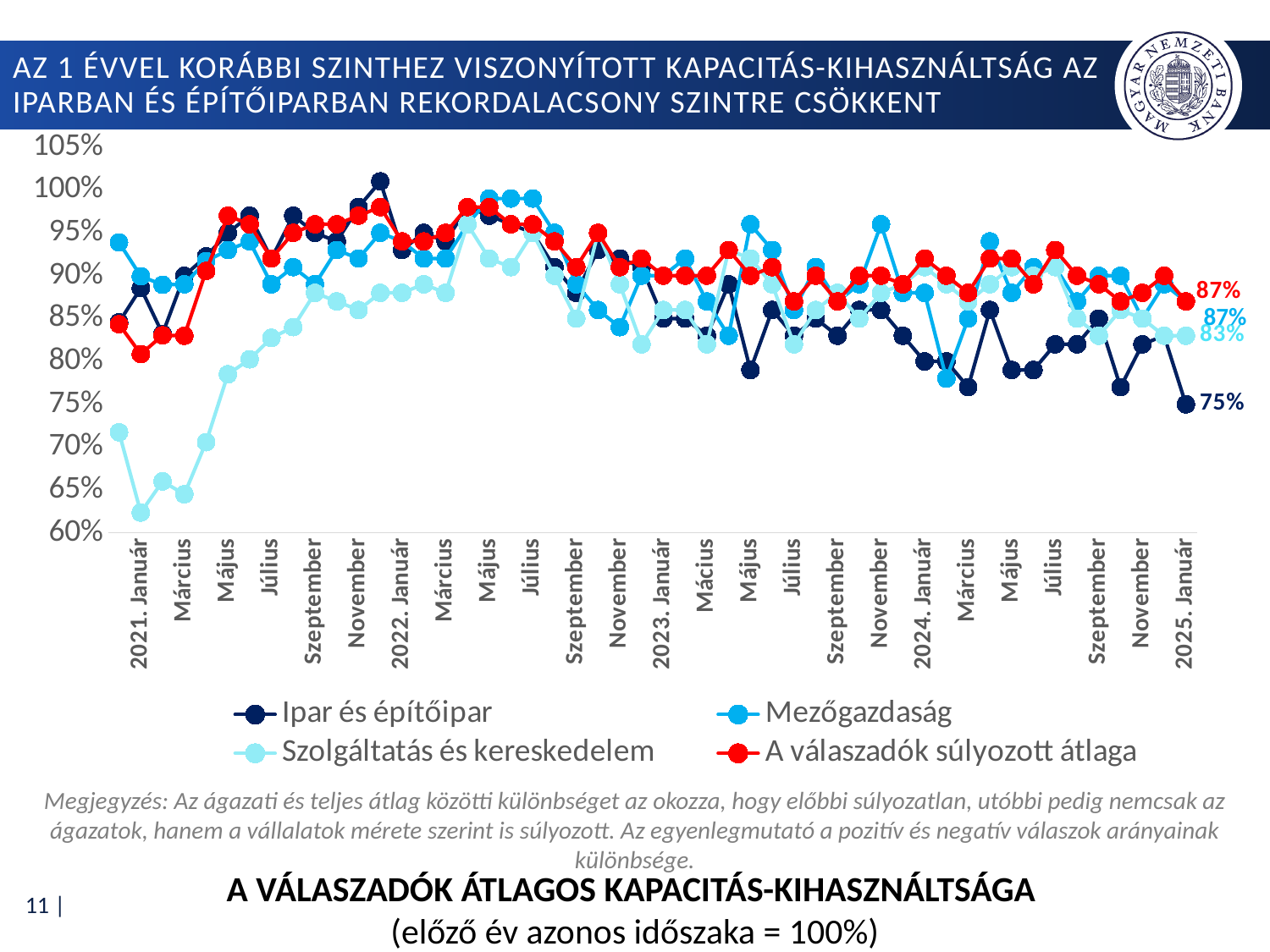
What is the title of the chart? A válaszadók átlagos kapacitás-kihasználtsága (előző év azonos időszaka = 100%) What is the value for Ipar és építőipar in 2025. Január? 75% Does the Szolgáltatás és kereskedelem series rise or fall between 2021. Január and 2022 Május? rise Which series has the lowest value in 2025. Január? Ipar és építőipar What kind of chart is shown on the slide? line chart In 2025. Január, which is larger: Ipar és építőipar or Szolgáltatás és kereskedelem? Szolgáltatás és kereskedelem What is the value for A válaszadók súlyozott átlaga in 2025. Január? 87% What is the difference between Szolgáltatás és kereskedelem and Ipar és építőipar in 2025. Január? 8 percentage points What is the value for Mezőgazdaság in 2025. Január? 87% How many series does the legend list? 4 Is the value for Szolgáltatás és kereskedelem in 2021. Január greater or less than 75%? less What is the value for Szolgáltatás és kereskedelem in 2025. Január? 83%